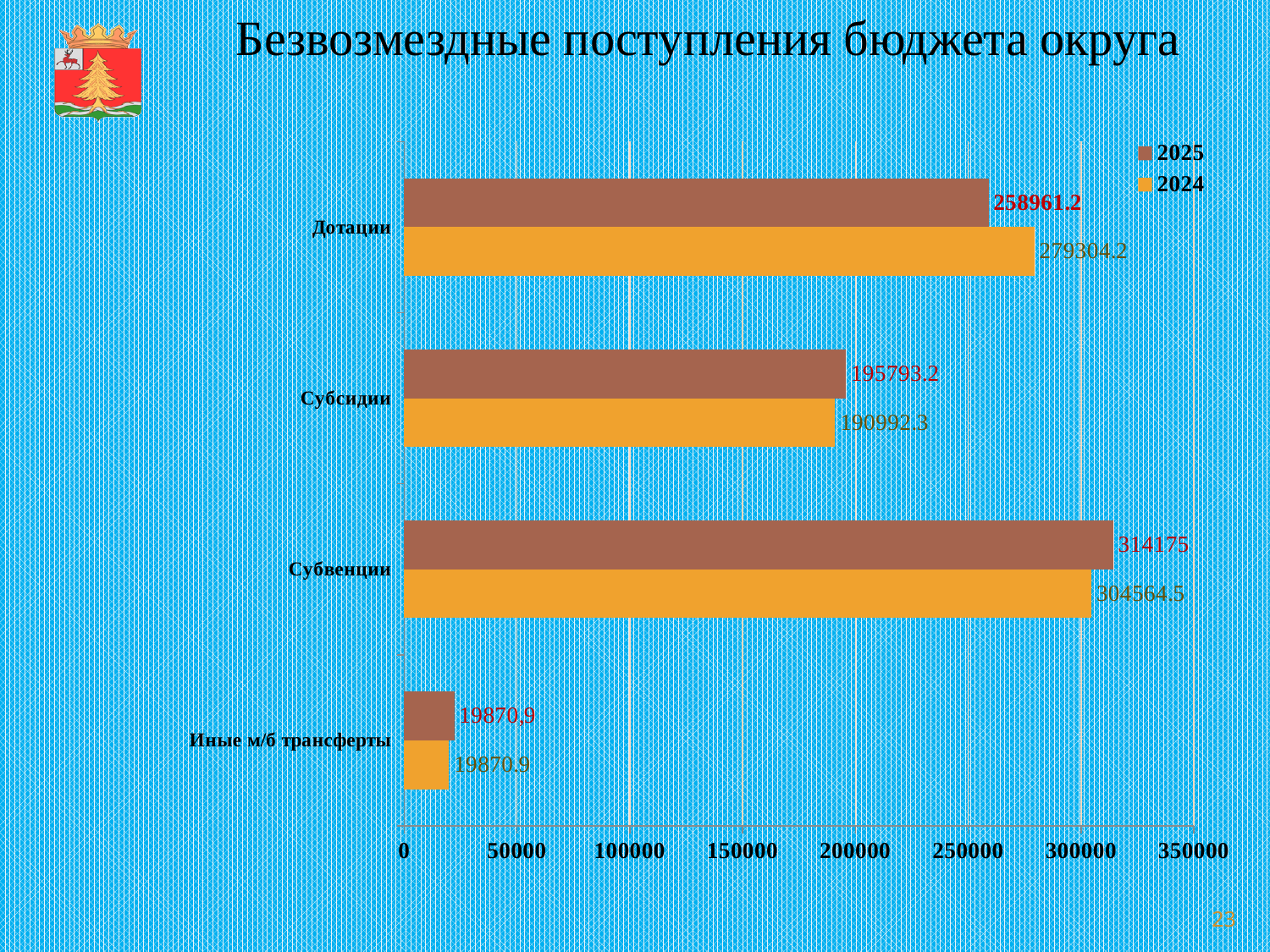
What is the difference between the 2025 and 2024 values for Субвенции? 9610.5 What is the value for Субсидии in the 2024 series? 190992.3 What is the value for Иные м/б трансферты in the 2025 series? 19870,9 Which category has the lowest value in the 2024 series? Иные м/б трансферты How many series does the legend list? 2 What is the difference between the 2024 and 2025 values for Дотации? 20343 For Субсидии, which series has the larger value, 2025 or 2024? 2025 What is the value for Дотации in the 2025 series? 258961.2 Which category has the highest value in the 2025 series? Субвенции How many categories are shown on the chart? 4 What type of chart is shown on the slide? Bar chart What is the value for Субвенции in the 2024 series? 304564.5